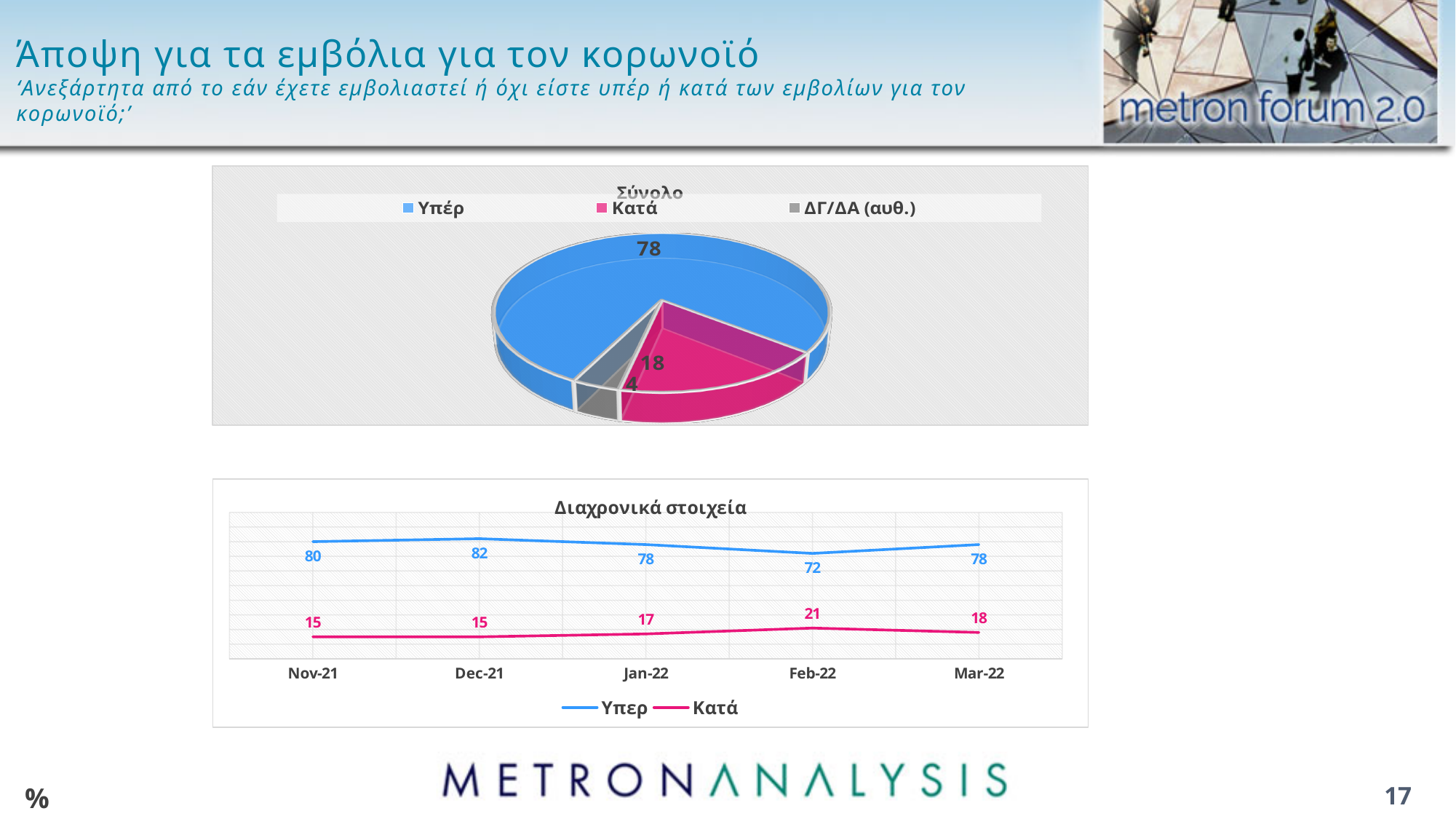
In the chart titled 'Διαχρονικά στοιχεία', in which month is the 'Κατά' value highest? Feb-22 In the pie chart titled 'Σύνολο', what is the difference between the values for 'Υπέρ' and 'Κατά'? 60 In the pie chart titled 'Σύνολο', what is the value for 'Υπέρ'? 78 In the pie chart titled 'Σύνολο', how many categories does the legend list? 3 In the chart titled 'Διαχρονικά στοιχεία', what is the difference between the 'Υπερ' values in Dec-21 and Feb-22? 10 In the chart titled 'Διαχρονικά στοιχεία', what is the value for 'Υπερ' in Feb-22? 72 In the pie chart titled 'Σύνολο', which category has the smallest slice? ΔΓ/ΔΑ (αυθ.) In the chart titled 'Διαχρονικά στοιχεία', in which month is the 'Υπερ' value highest? Dec-21 What kind of chart is the chart titled 'Διαχρονικά στοιχεία'? Line chart In the chart titled 'Διαχρονικά στοιχεία', what is the value for 'Κατά' in Jan-22? 17 In the chart titled 'Διαχρονικά στοιχεία', how many series does the legend list? 2 In the pie chart titled 'Σύνολο', what is the value for 'Κατά'? 18